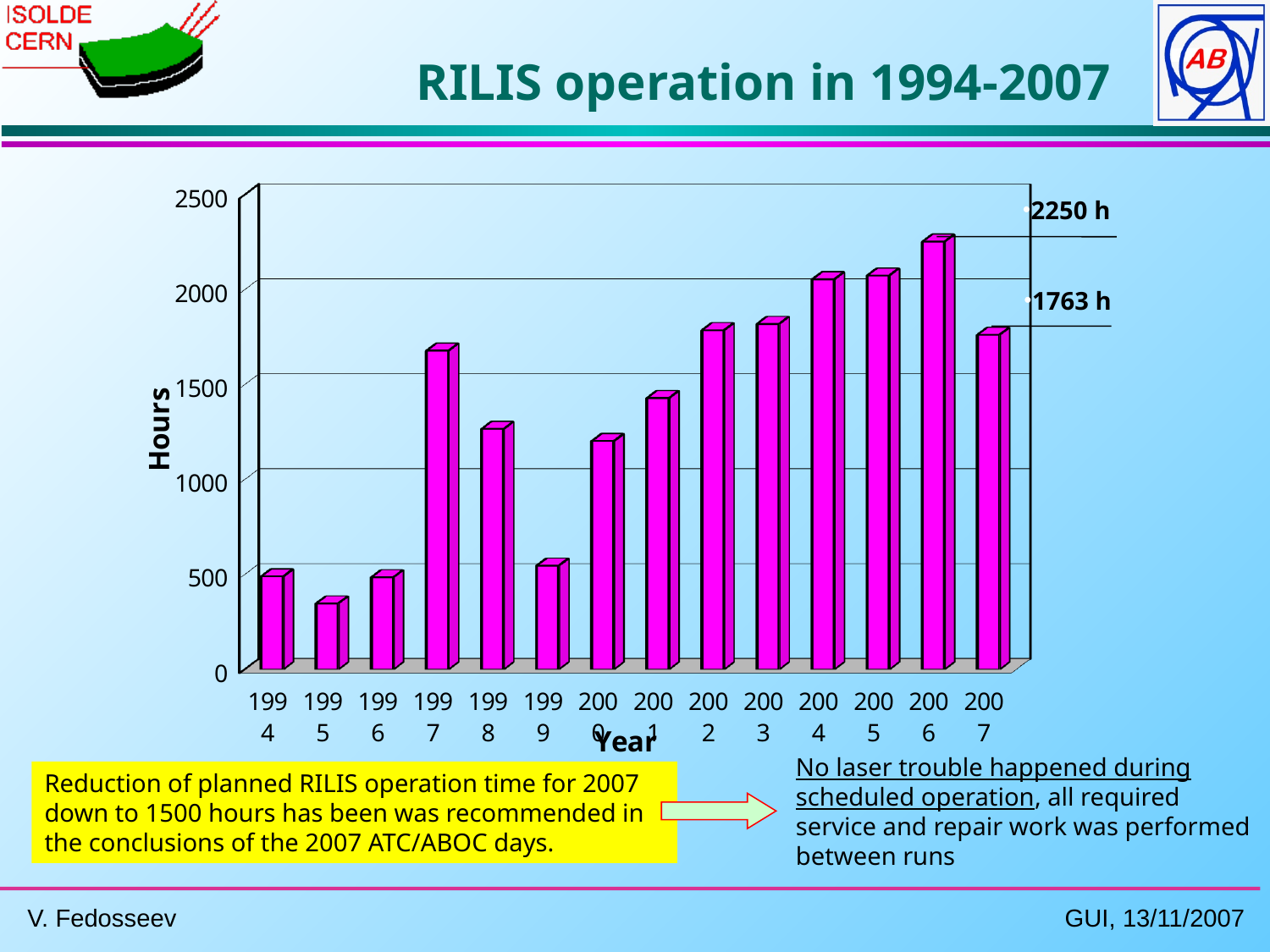
What is the title of the vertical axis of the chart? Hours What is the labelled value for RILIS operation hours in 2007? 1763 h Which year has the highest number of operation hours? 2006 What is the difference between the labelled hours for 2006 and 2007? 487 h Is the value for 1999 greater or less than 1000? less What type of chart is shown on the slide? bar chart Is the value for 1997 greater or less than 1500? greater Do the operation hours generally rise or fall from 2000 to 2006? rise Which year has the lowest number of operation hours? 1995 What is the labelled value for RILIS operation hours in 2006? 2250 h How many years are plotted on the x axis of the chart? 14 Which year has more operation hours, 1997 or 1998? 1997